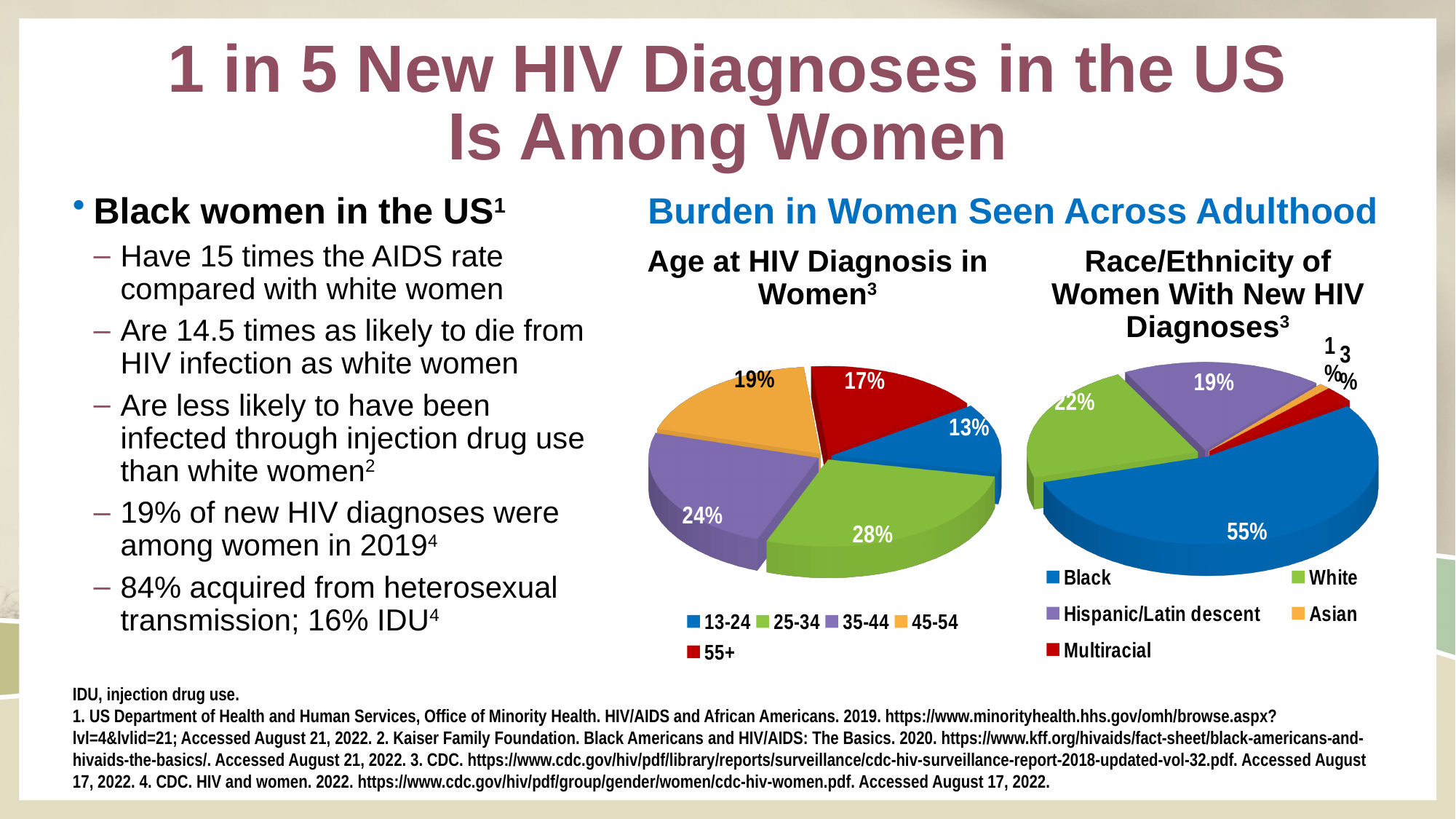
In the 'Race/Ethnicity of Women With New HIV Diagnoses' chart, which group has the largest share? Black In the 'Race/Ethnicity of Women With New HIV Diagnoses' chart, what percentage is shown for Black women? 55% In the 'Race/Ethnicity of Women With New HIV Diagnoses' chart, which is larger, the share for White or for Hispanic/Latin descent? White In the 'Age at HIV Diagnosis in Women' chart, what is the difference in percentage points between the 35-44 and 55+ groups? 7 In the 'Race/Ethnicity of Women With New HIV Diagnoses' chart, how many categories does the legend list? 5 In the 'Age at HIV Diagnosis in Women' chart, which age group has the smallest share? 13-24 In the 'Race/Ethnicity of Women With New HIV Diagnoses' chart, what percentage is shown for White women? 22% What type of chart is used for 'Race/Ethnicity of Women With New HIV Diagnoses'? Pie chart In the 'Age at HIV Diagnosis in Women' chart, what percentage is shown for the 25-34 age group? 28% In the 'Age at HIV Diagnosis in Women' chart, what percentage is shown for the 13-24 age group? 13% In the 'Age at HIV Diagnosis in Women' chart, how many age groups are shown? 5 In the 'Age at HIV Diagnosis in Women' chart, which age group has the largest share? 25-34